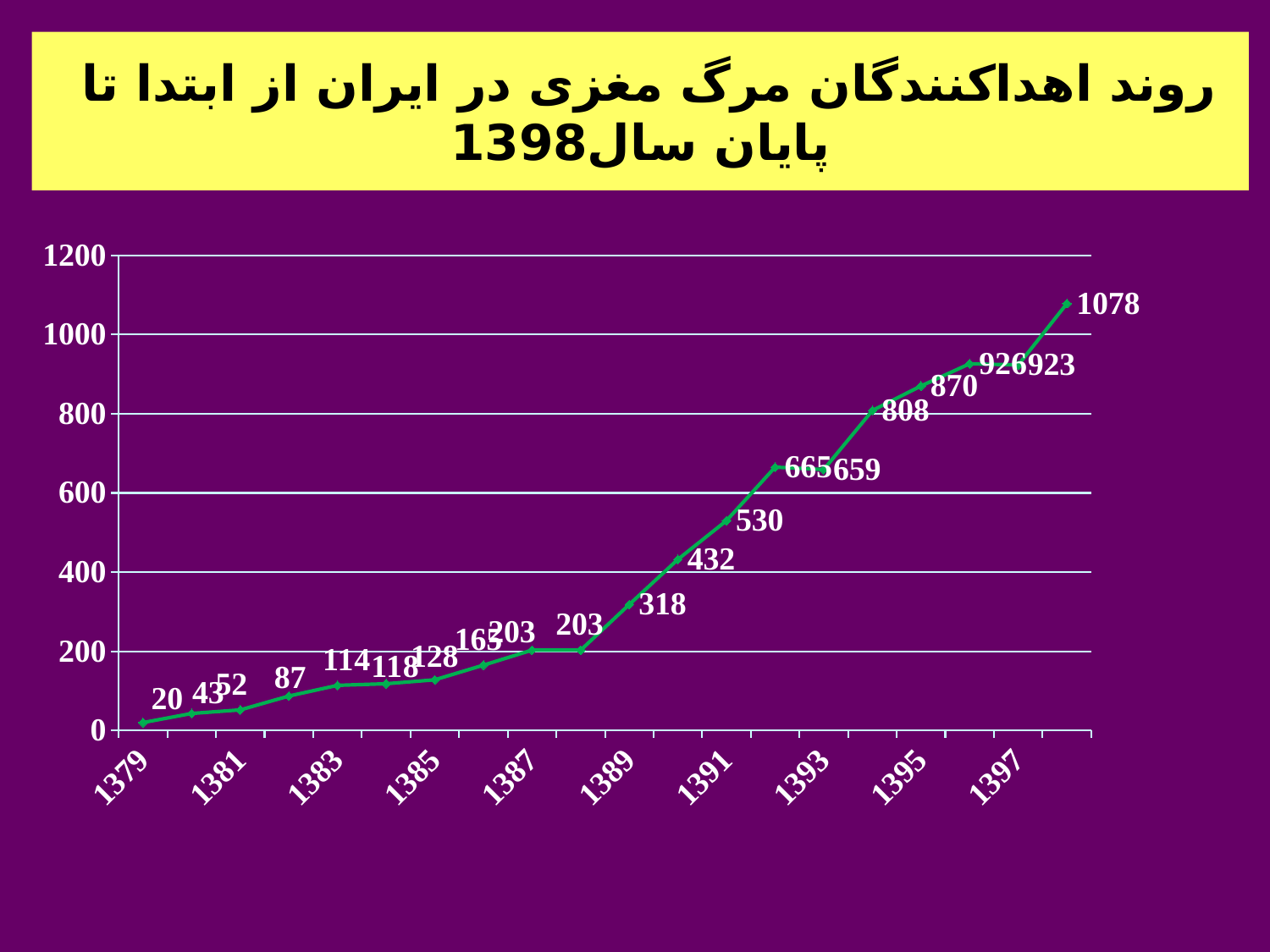
What is the difference between the values for 1391 and 1389? 212 What is the value plotted for the year 1379? 20 What is the value of the last data point on the line? 1078 How many data points are plotted on the line? 20 What type of chart is shown on the slide? line chart What is the value plotted for the year 1395? 870 What is the lowest value shown on the chart? 20 Do the values generally rise or fall from 1379 to the end of the series? rise What is the highest value shown on the chart? 1078 Is the value for 1385 greater or less than 200? less What is the value plotted for the year 1389? 318 Which year has the larger value, 1393 or 1397? 1397